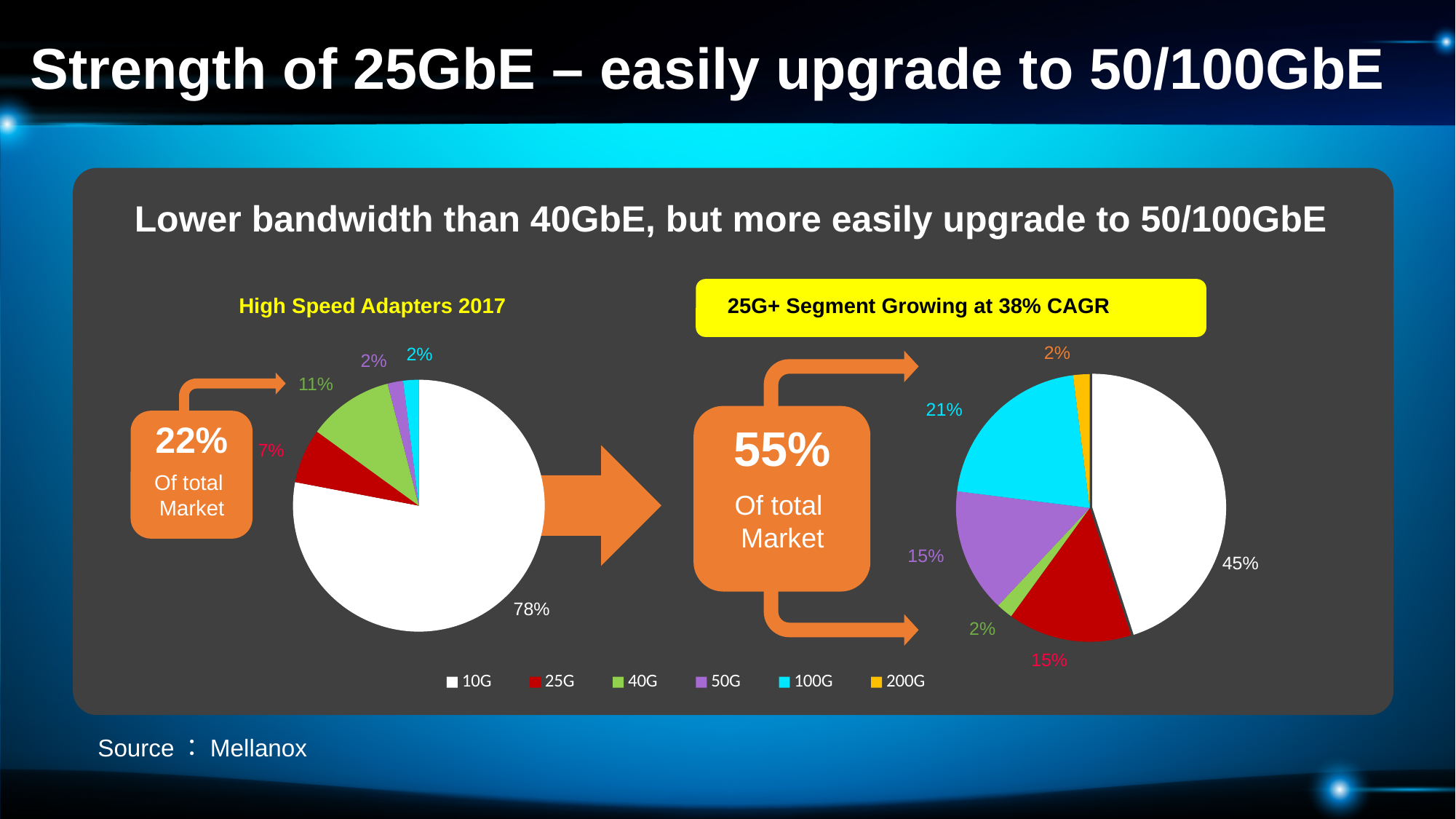
In the left pie chart titled 'High Speed Adapters 2017', what share does the 10G slice have? 78% In the right pie chart, which category has the largest slice? 10G In the right pie chart, what share does the 10G slice have? 45% In the right pie chart, what share does the 100G slice have? 21% What type of chart is used on the left side of the slide under 'High Speed Adapters 2017'? Pie chart In the right pie chart, which slice is larger, 100G or 25G? 100G In the left pie chart titled 'High Speed Adapters 2017', what share does the 40G slice have? 11% In the right pie chart, what share does the 200G slice have? 2% In the left pie chart titled 'High Speed Adapters 2017', what share does the 25G slice have? 7% How many series does the shared legend below the pie charts list? 6 What is the difference between the 10G share in the left pie chart (78%) and the 10G share in the right pie chart (45%)? 33% In the left pie chart titled 'High Speed Adapters 2017', which category has the largest slice? 10G